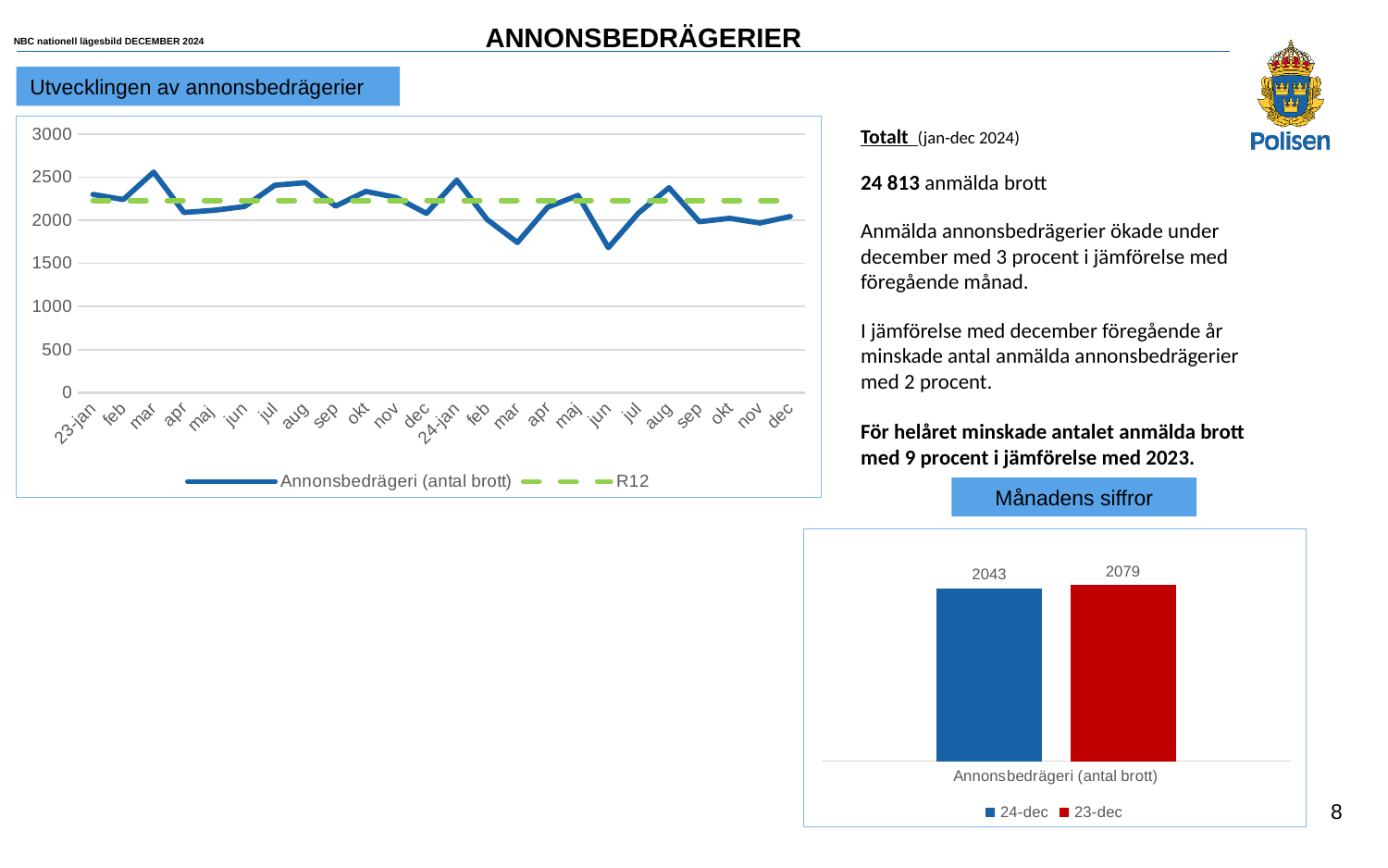
In the 'Utvecklingen av annonsbedrägerier' chart, which month has the highest value for Annonsbedrägeri (antal brott)? 23-mar In the 'Månadens siffror' chart, what is the value for 23-dec? 2079 In the 'Månadens siffror' chart, what is the value for 24-dec? 2043 In the 'Månadens siffror' chart, what is the difference between the 23-dec and 24-dec values? 36 In the 'Utvecklingen av annonsbedrägerier' chart, is the value of Annonsbedrägeri (antal brott) for 23-mar greater or less than 2000? greater What type of chart is the 'Utvecklingen av annonsbedrägerier' chart? line chart In the 'Utvecklingen av annonsbedrägerier' chart, what are the two series named in the legend? Annonsbedrägeri (antal brott) and R12 In the 'Månadens siffror' chart, which is larger, 24-dec or 23-dec? 23-dec What type of chart is the 'Månadens siffror' chart? bar chart In the 'Utvecklingen av annonsbedrägerier' chart, is the value of Annonsbedrägeri (antal brott) for jun 2024 greater or less than 2000? less How many series does the legend of the 'Utvecklingen av annonsbedrägerier' chart list? 2 In the 'Utvecklingen av annonsbedrägerier' chart, is the value of Annonsbedrägeri (antal brott) for mar 2024 greater or less than 2000? less